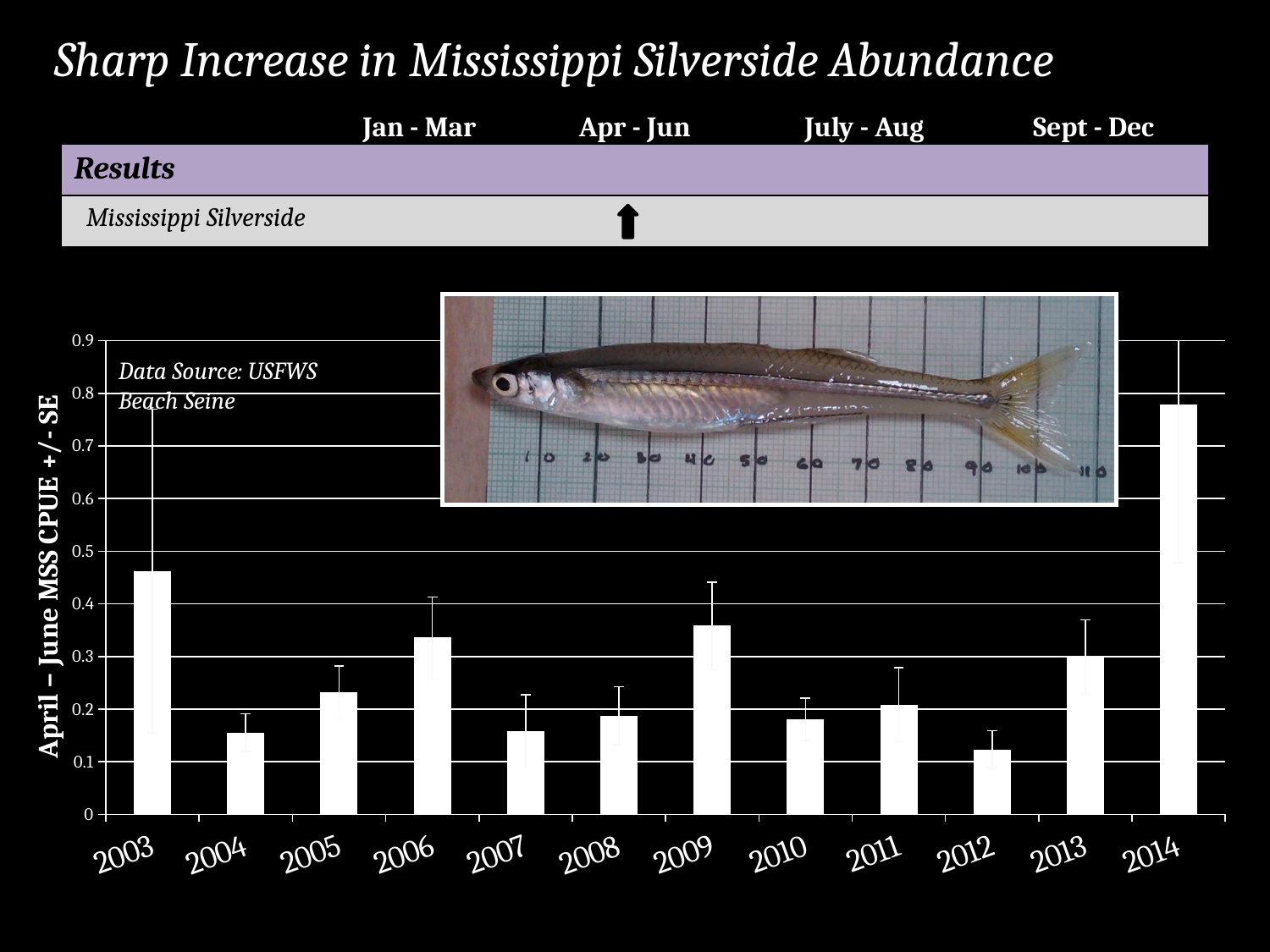
Is the value for 2014 greater or less than 0.7? greater Which is larger, the value for 2006 or the value for 2007? 2006 Which is larger, the value for 2013 or the value for 2010? 2013 What kind of chart is shown on the slide? bar chart What data source is cited on the chart? USFWS Beach Seine What is the label on the y axis of the chart? April – June MSS CPUE +/- SE Is the value for 2009 greater or less than 0.3? greater Is the value for 2012 greater or less than 0.2? less Which year has the lowest April–June MSS CPUE? 2012 Which year has the highest April–June MSS CPUE? 2014 How many years are plotted on the x axis of the chart? 12